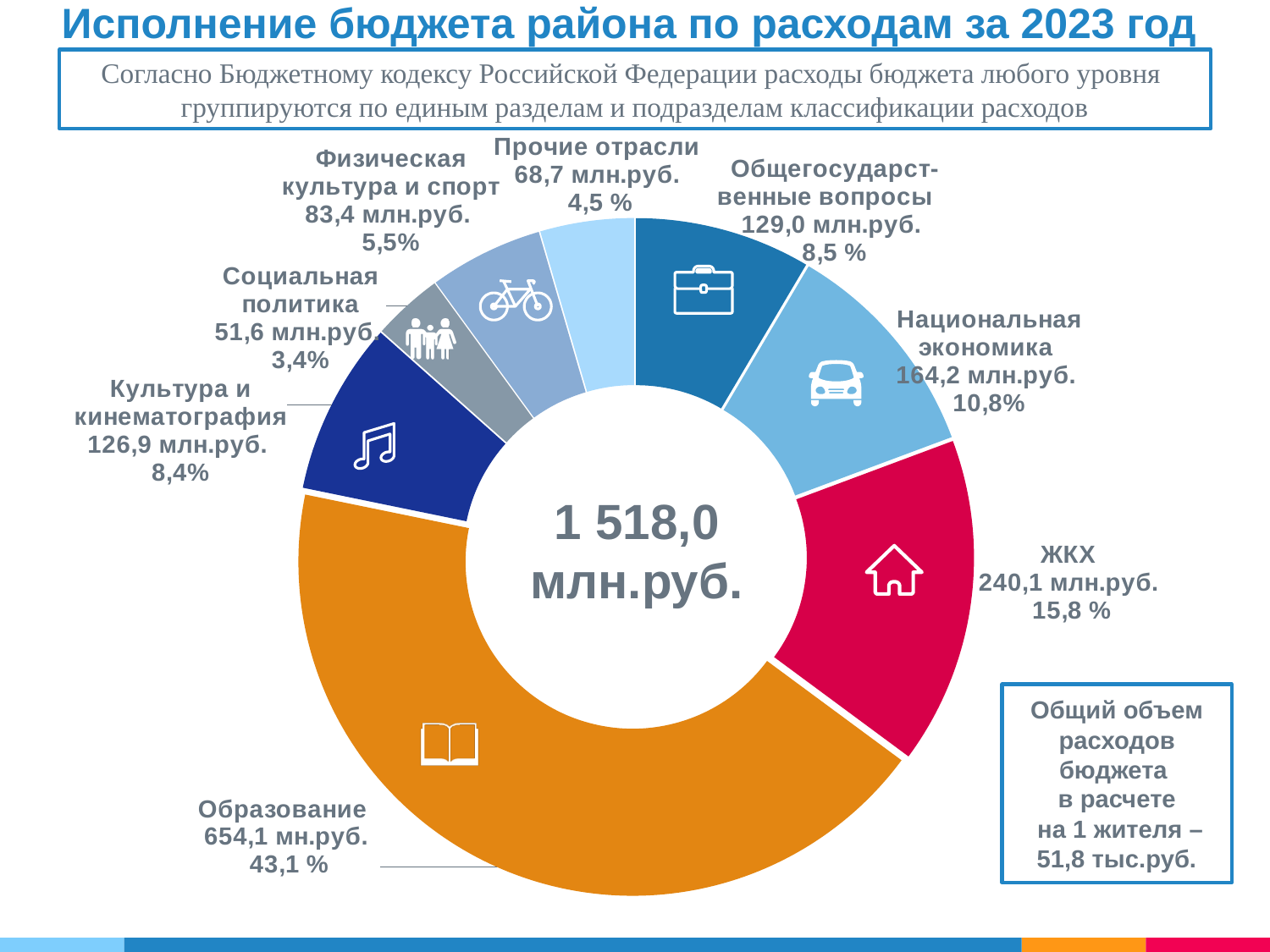
What percentage share is shown for Культура и кинематография? 8,4% Which category has the largest share of the chart? Образование Which is larger, Физическая культура и спорт or Прочие отрасли? Физическая культура и спорт What kind of chart is shown on the slide? Donut (pie) chart What is the difference in млн.руб. between ЖКХ and Общегосударственные вопросы? 111,1 млн.руб. What is the value for Национальная экономика? 164,2 млн.руб. What total value is printed in the centre of the chart? 1 518,0 млн.руб. What is the value for Образование on the chart? 654,1 мн.руб. Which category has the smallest share of the chart? Социальная политика What is the title of the slide? Исполнение бюджета района по расходам за 2023 год How many categories are shown on the chart? 8 What share of the chart does ЖКХ account for? 15,8 %